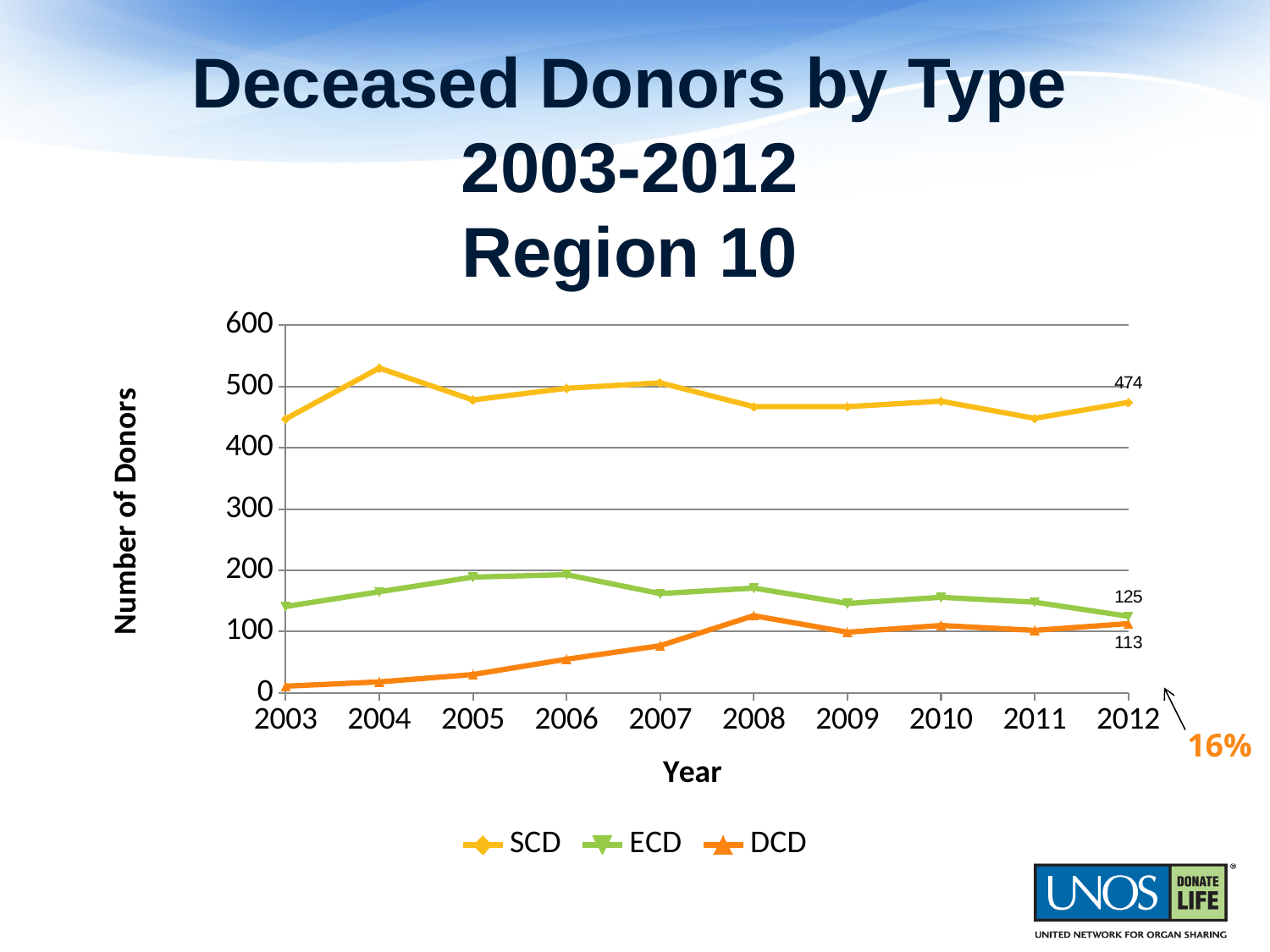
In which year does the SCD series reach its highest value? 2004 Is the value for DCD in 2006 greater or less than 100? less How many series does the legend list? 3 What type of chart is shown on the slide? line chart What is the number of DCD donors in 2012? 113 What is the number of SCD donors in 2012? 474 Which series has the highest value in 2012? SCD What is the number of ECD donors in 2012? 125 Is the value for SCD in 2004 greater or less than 500? greater What is the difference between the SCD and ECD values in 2012? 349 Does the DCD series rise or fall from 2003 to 2008? rise How many years are plotted along the x axis? 10